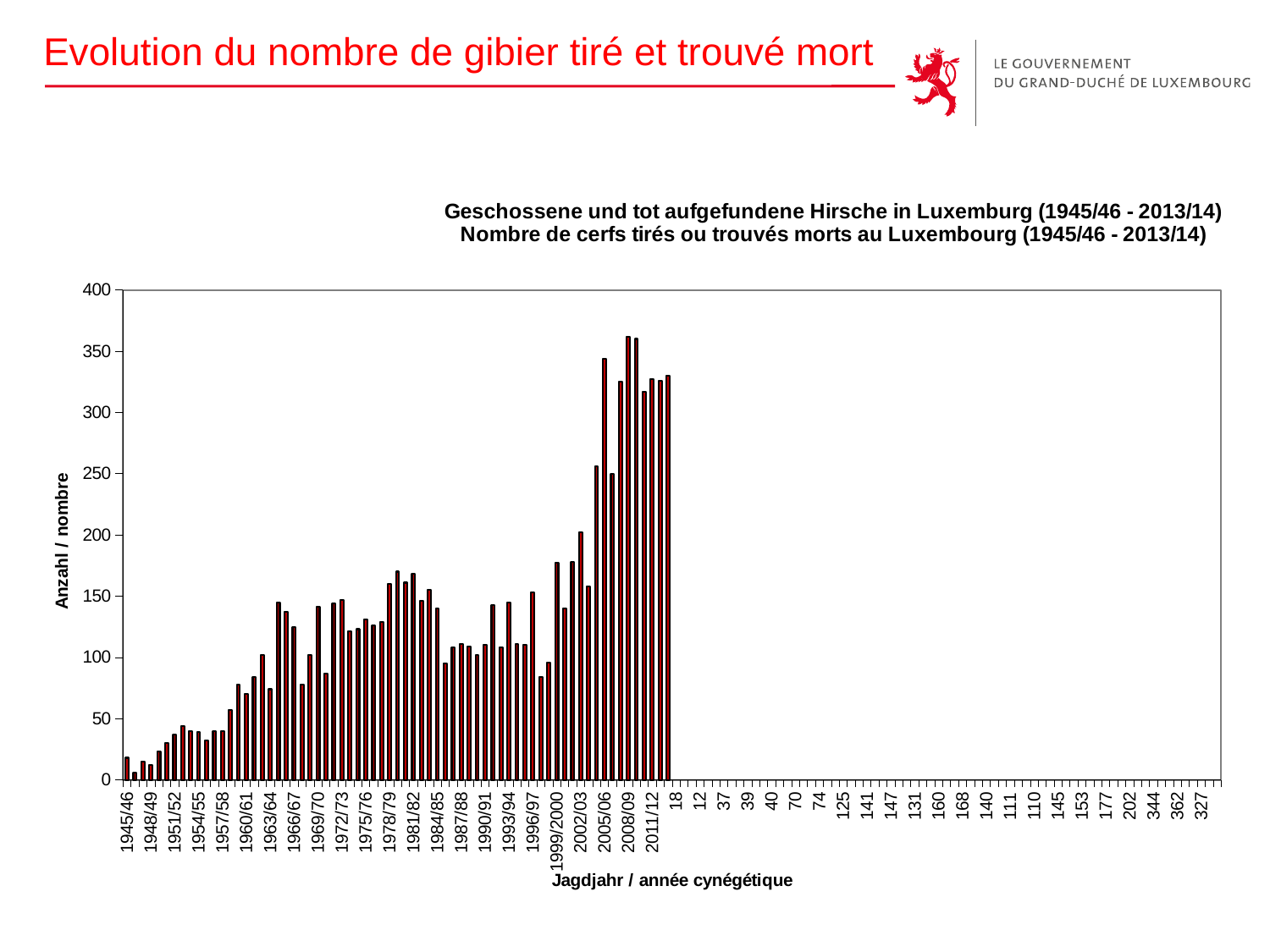
Which is larger, the value for 1963/64 or the value for 1951/52? 1963/64 Which is larger, the value for 2011/12 or the value for 1945/46? 2011/12 What kind of chart is shown on the slide? bar chart Is the value for 1960/61 greater or less than 100? less Overall, do the values rise or fall from 1945/46 to 2013/14? rise Is the value for 1978/79 greater or less than 100? greater Is the value for 2011/12 greater or less than 300? greater What is the label of the vertical axis? Anzahl / nombre What is the title of the chart (French line)? Nombre de cerfs tirés ou trouvés morts au Luxembourg (1945/46 - 2013/14)